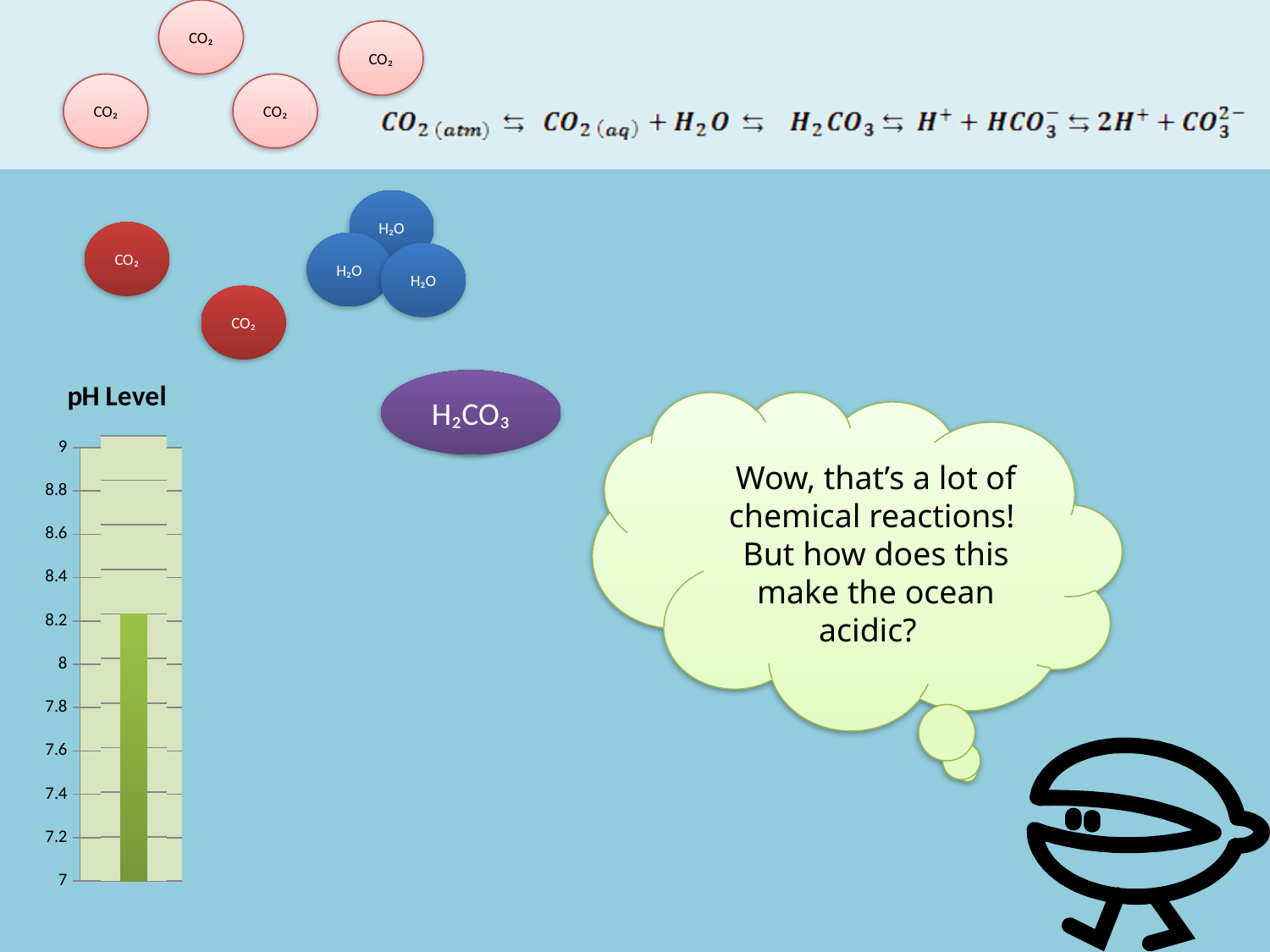
What is the title of the chart on the slide? pH Level In the pH Level chart, is the value of the bar greater or less than 8.4? less In the pH Level chart, is the value of the bar greater or less than 7.8? greater In the pH Level chart, is the value of the bar greater or less than 8? greater What kind of chart is shown on the slide? bar chart What is the highest value shown on the vertical axis of the pH Level chart? 9 How many bars are plotted in the pH Level chart? 1